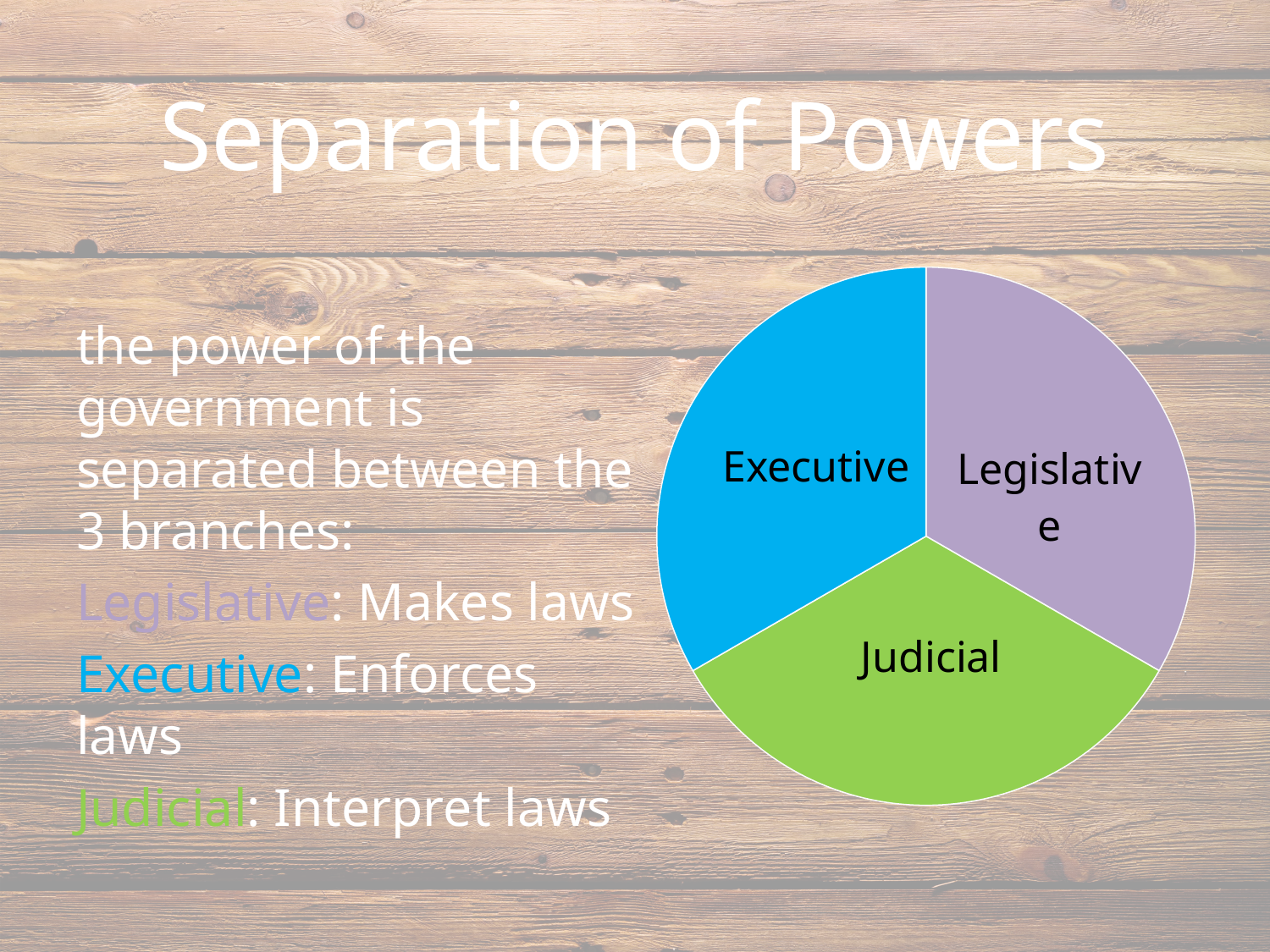
What colour is the Executive slice of the pie chart? blue Which branch is labelled on the purple slice of the pie chart? Legislative What kind of chart is shown on the slide? pie chart Which slice of the pie chart is green? Judicial How many slices does the pie chart have? 3 Which three categories are labelled on the pie chart? Executive, Legislative, Judicial